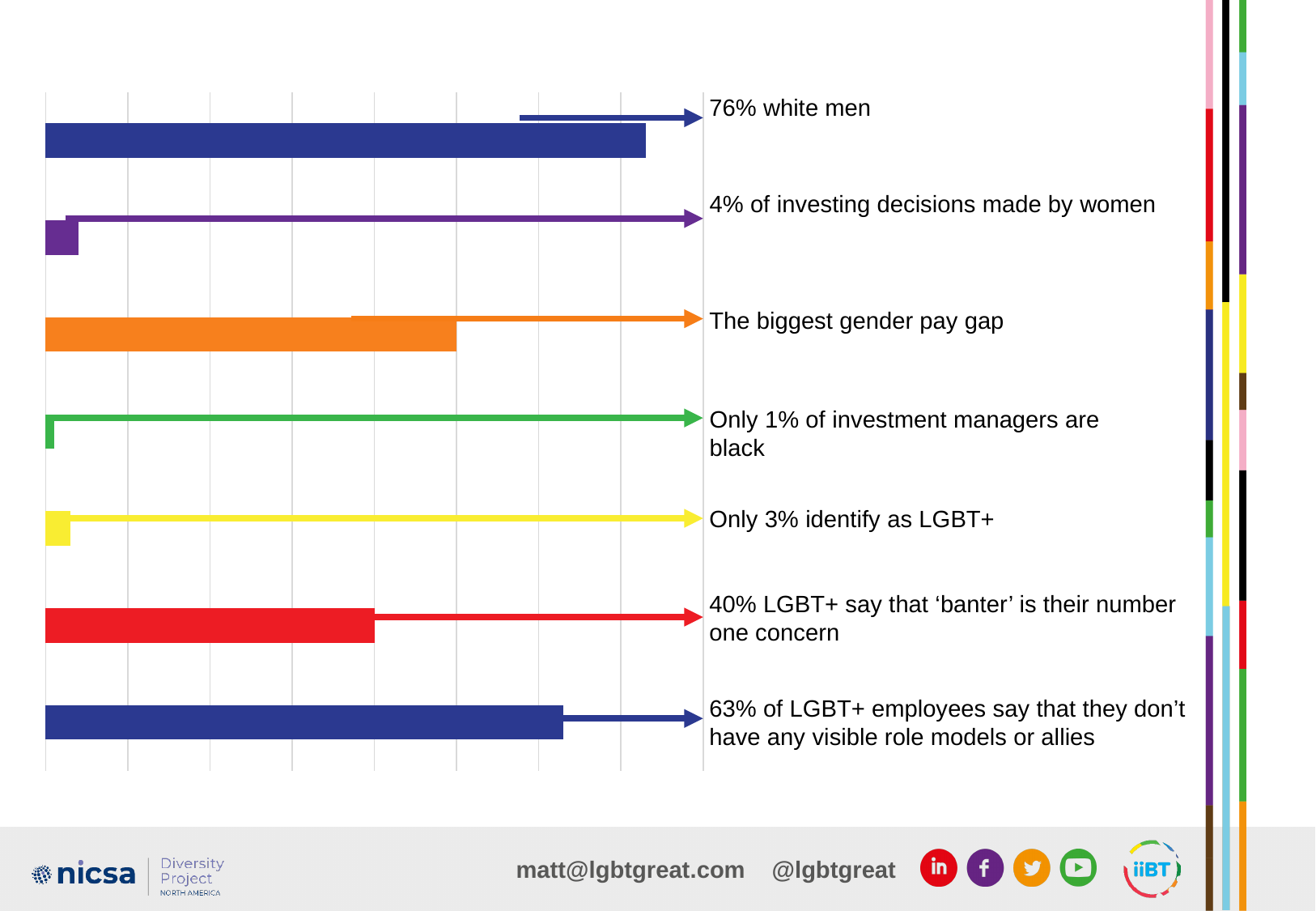
What percentage identify as LGBT+, according to the chart? 3% How many bars are plotted in the chart? 7 What kind of chart is shown on the slide? bar chart Which is larger: the share of white men or the share of LGBT+ employees without visible role models or allies? white men (76%) What percentage of investment managers are black, according to the chart annotation? 1% What percentage of LGBT+ say that 'banter' is their number one concern? 40% What colour is the bar for 'The biggest gender pay gap'? orange Which annotated statistic has the longest bar in the chart? 76% white men What is the difference in percentage points between the 76% white men figure and the 63% of LGBT+ employees without visible role models or allies? 13 percentage points What percentage of LGBT+ employees say they don't have any visible role models or allies? 63% Which annotated statistic has the shortest bar in the chart? Only 1% of investment managers are black What percentage of investing decisions are made by women, according to the chart? 4%